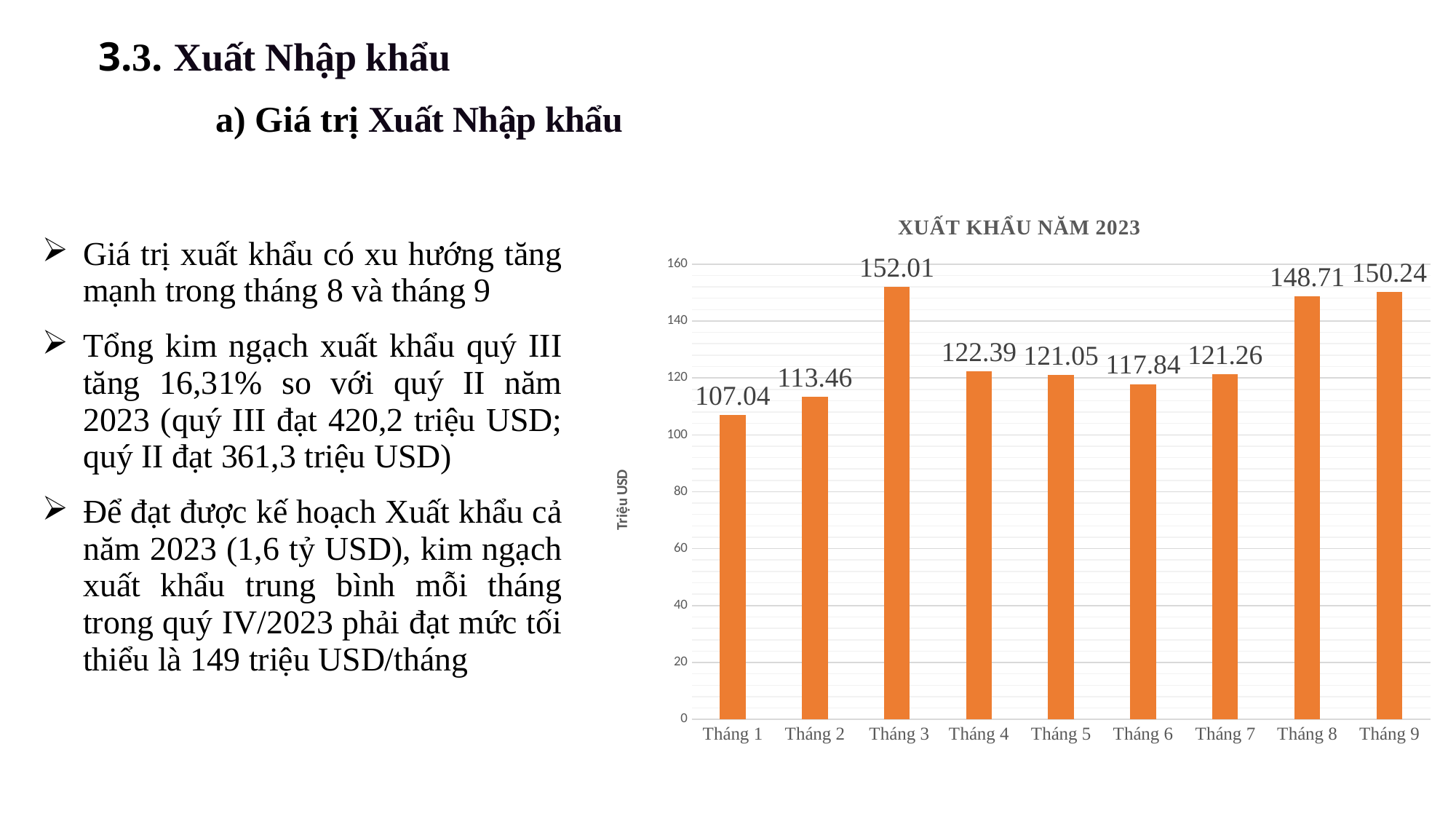
Which month has the highest value? Tháng 3 Which is larger, the value for Tháng 4 or the value for Tháng 6? Tháng 4 Which month has the lowest value? Tháng 1 What is the value for Tháng 1? 107.04 Is the value for Tháng 2 greater or less than 120? less What is the title of the chart? XUẤT KHẨU NĂM 2023 What is the value for Tháng 3? 152.01 What is the difference between the values for Tháng 3 and Tháng 1? 44.97 What is the value for Tháng 8? 148.71 What is the difference between the values for Tháng 9 and Tháng 8? 1.53 How many months are shown on the x axis? 9 What kind of chart is shown on the slide? bar chart